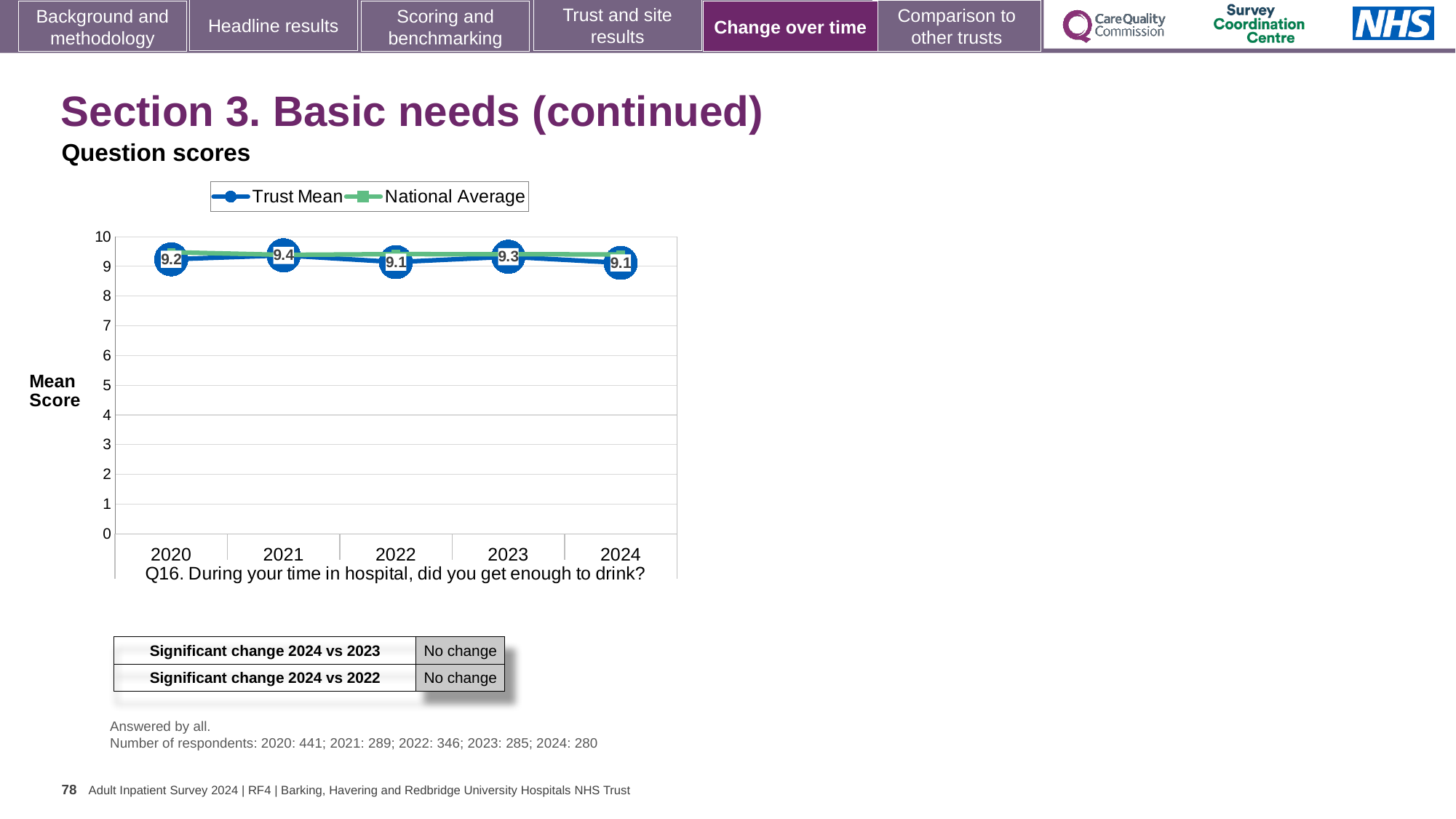
What kind of chart is shown on the slide? line chart Does the Trust Mean score rise or fall from 2023 to 2024? fall How many series does the legend list? 2 Is the National Average value for 2020 greater or less than 8? greater How many years are plotted on the x axis? 5 Which year has the larger Trust Mean score, 2021 or 2024? 2021 What is the Trust Mean score for 2021? 9.4 What is the Trust Mean score for 2024? 9.1 What is the Trust Mean score for 2020? 9.2 What is the lowest Trust Mean score shown on the chart? 9.1 What is the difference between the Trust Mean scores for 2021 and 2022? 0.3 In which year is the Trust Mean score highest? 2021